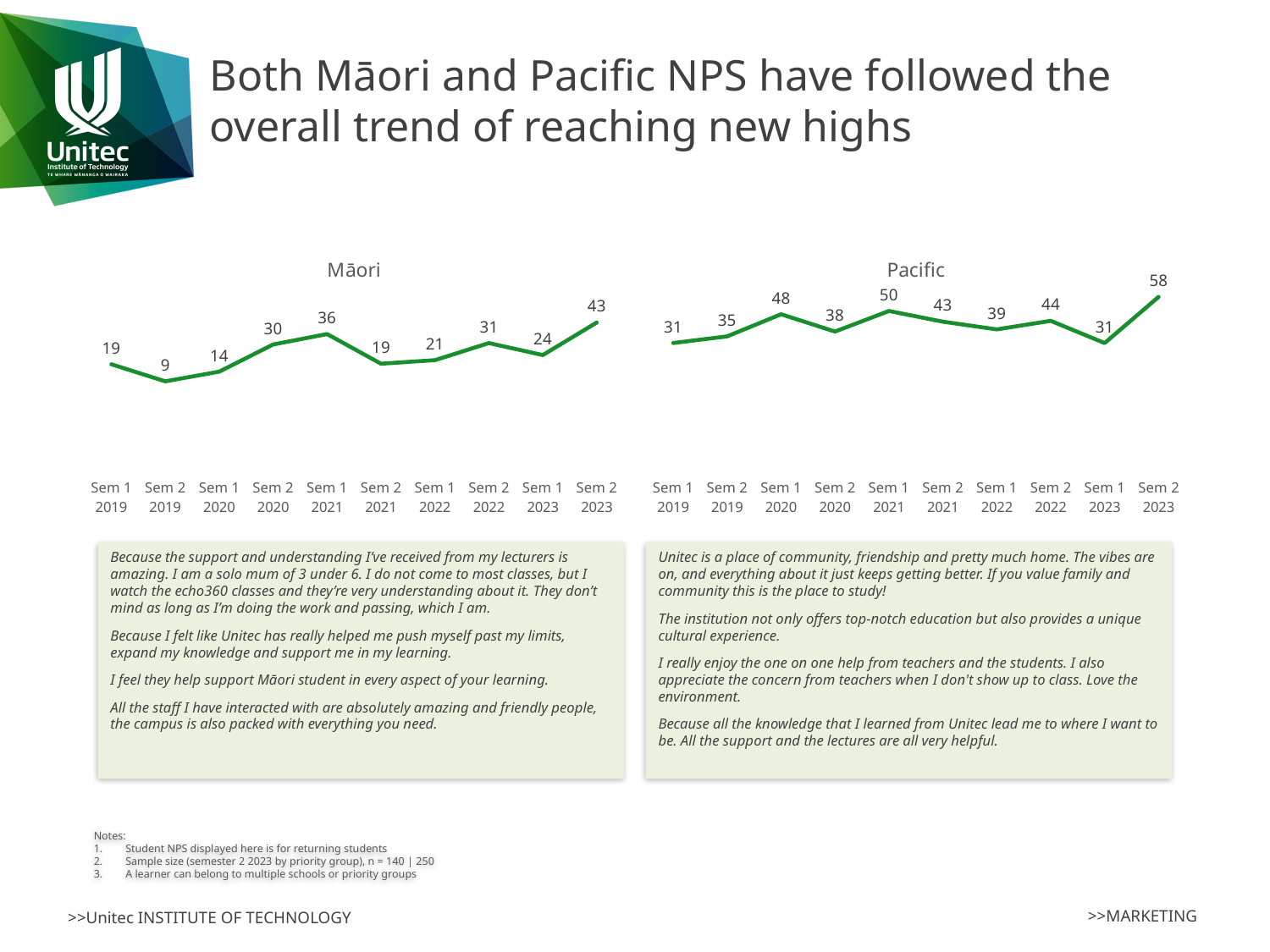
In the Māori chart, what is the difference between the Sem 1 2021 value and the Sem 2 2021 value? 17 In the Pacific chart, what is the NPS value for Sem 1 2021? 50 In the Pacific chart, which semester has the highest NPS value? Sem 2 2023 In the Māori chart, what is the NPS value for Sem 1 2019? 19 In the Māori chart, what is the NPS value for Sem 2 2023? 43 In the Pacific chart, what is the difference between the Sem 2 2023 value and the Sem 1 2023 value? 27 In the Pacific chart, does the value rise or fall from Sem 1 2023 to Sem 2 2023? Rise What is the title of the chart on the left side of the slide? Māori What type of chart is the Pacific chart? Line chart How many data points are plotted in the Māori chart? 10 Which is larger: the Māori value for Sem 2 2023 or the Pacific value for Sem 2 2023? Pacific In the Māori chart, which semester has the lowest NPS value? Sem 2 2019